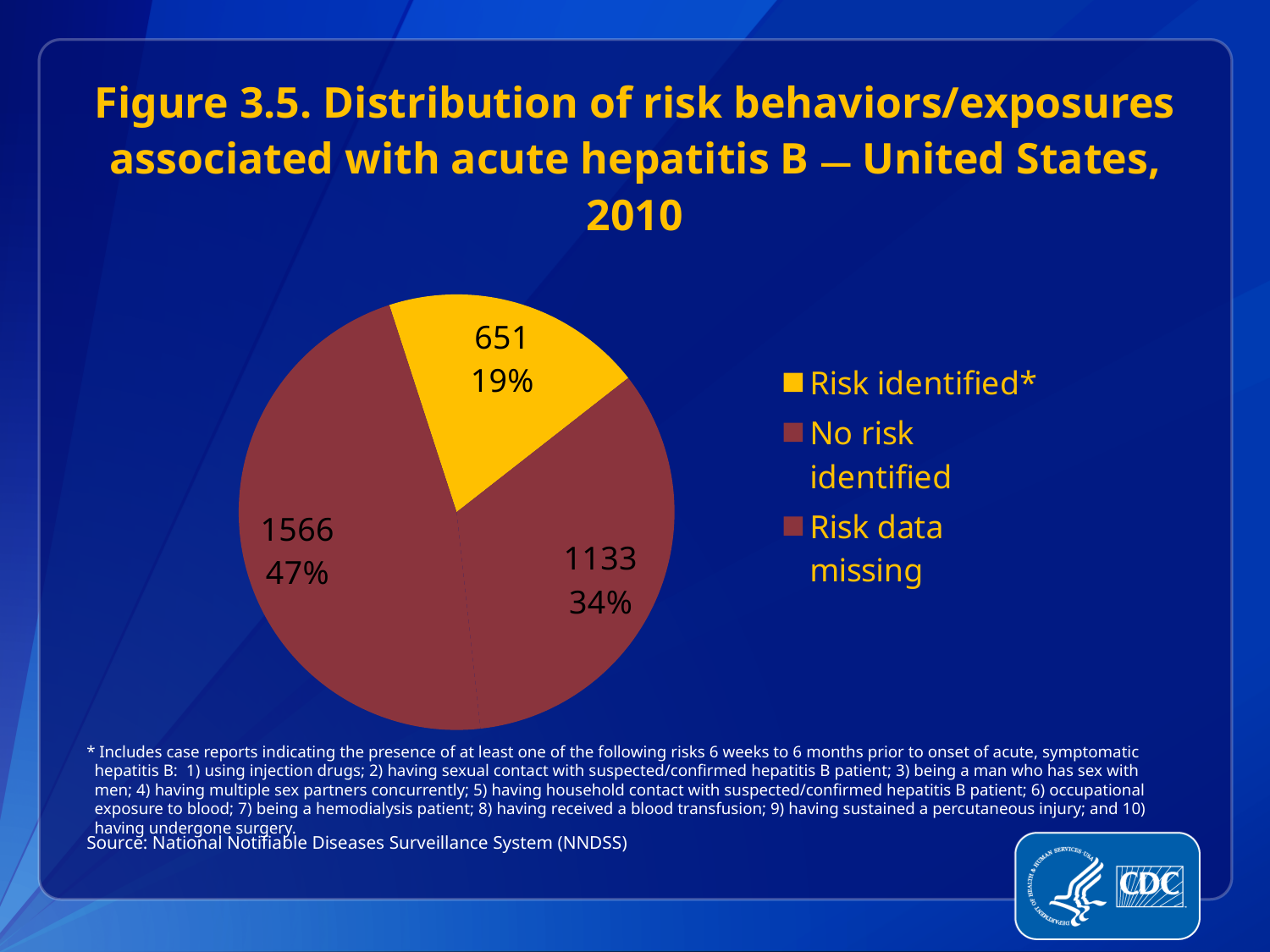
What percentage does the largest slice of the pie represent? 47% What kind of chart is shown on the slide? pie chart Which legend category corresponds to the smallest slice of the pie? Risk identified* What colour is the Risk identified* slice in the pie chart? yellow What is the total of the three slice values shown on the pie chart? 3350 What is the difference between the largest slice value (1566) and the Risk identified* value (651)? 915 What percentage of the pie does the Risk identified* slice represent? 19% What is the number of cases in the Risk identified* slice? 651 Which is larger: the slice labeled 1133 or the slice labeled 651? 1133 What is the value of the largest slice of the pie? 1566 How many slices does the pie chart have? 3 How many entries does the legend list? 3